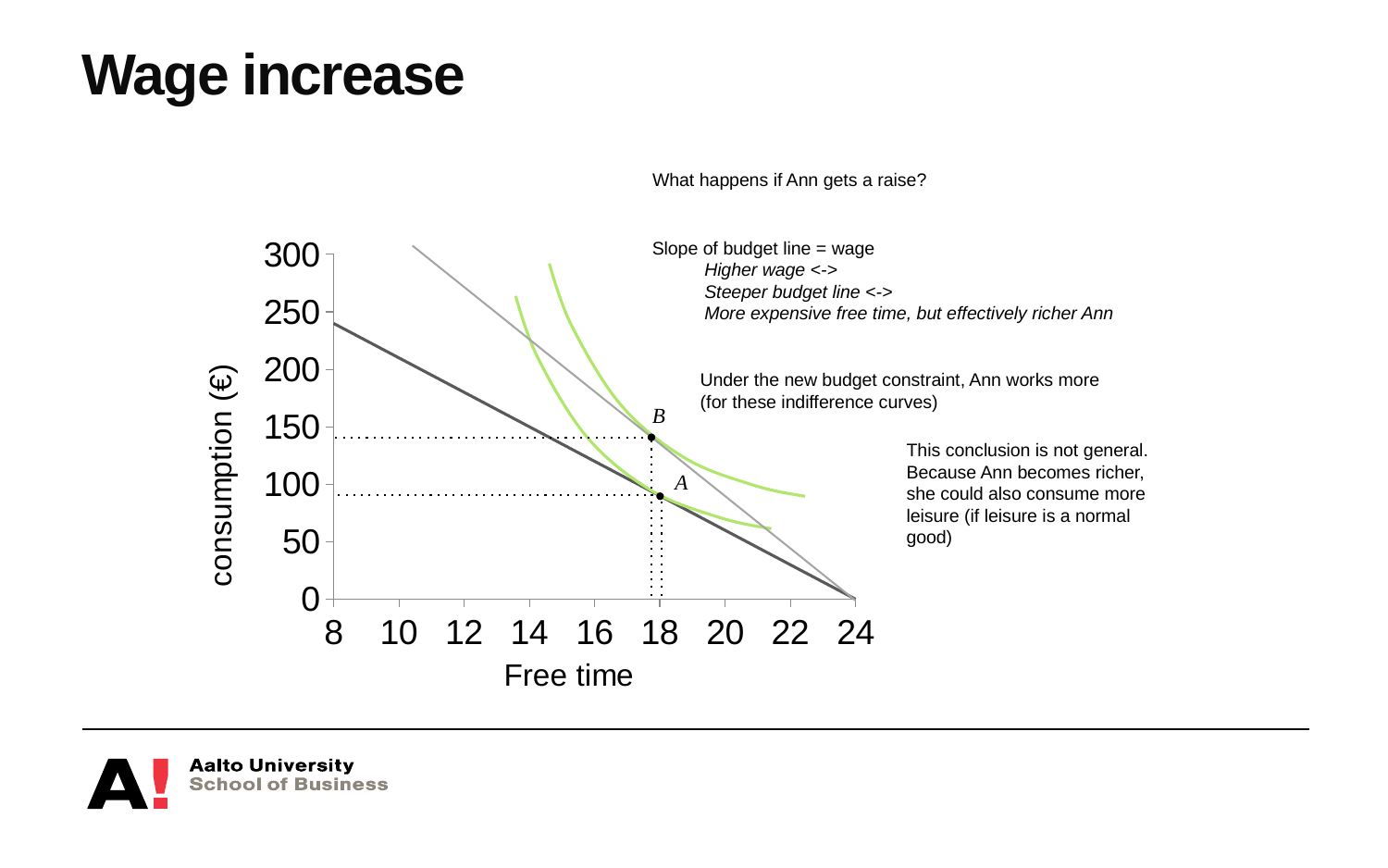
What is the label of the y axis? consumption (€) Is the consumption at point B greater or less than 100? greater What kind of chart is shown on the slide? line chart Is the free time at point A greater or less than 16? greater At what value of free time do both budget lines reach zero consumption? 24 How many labelled points are marked on the chart? 2 What is the highest value shown on the y axis? 300 Is the consumption at point A greater or less than 150? less What is the lowest value shown on the x axis? 8 What is the label of the x axis? Free time Do the budget lines rise or fall as free time increases along the x axis? fall Which labelled point, A or B, has the higher consumption? B